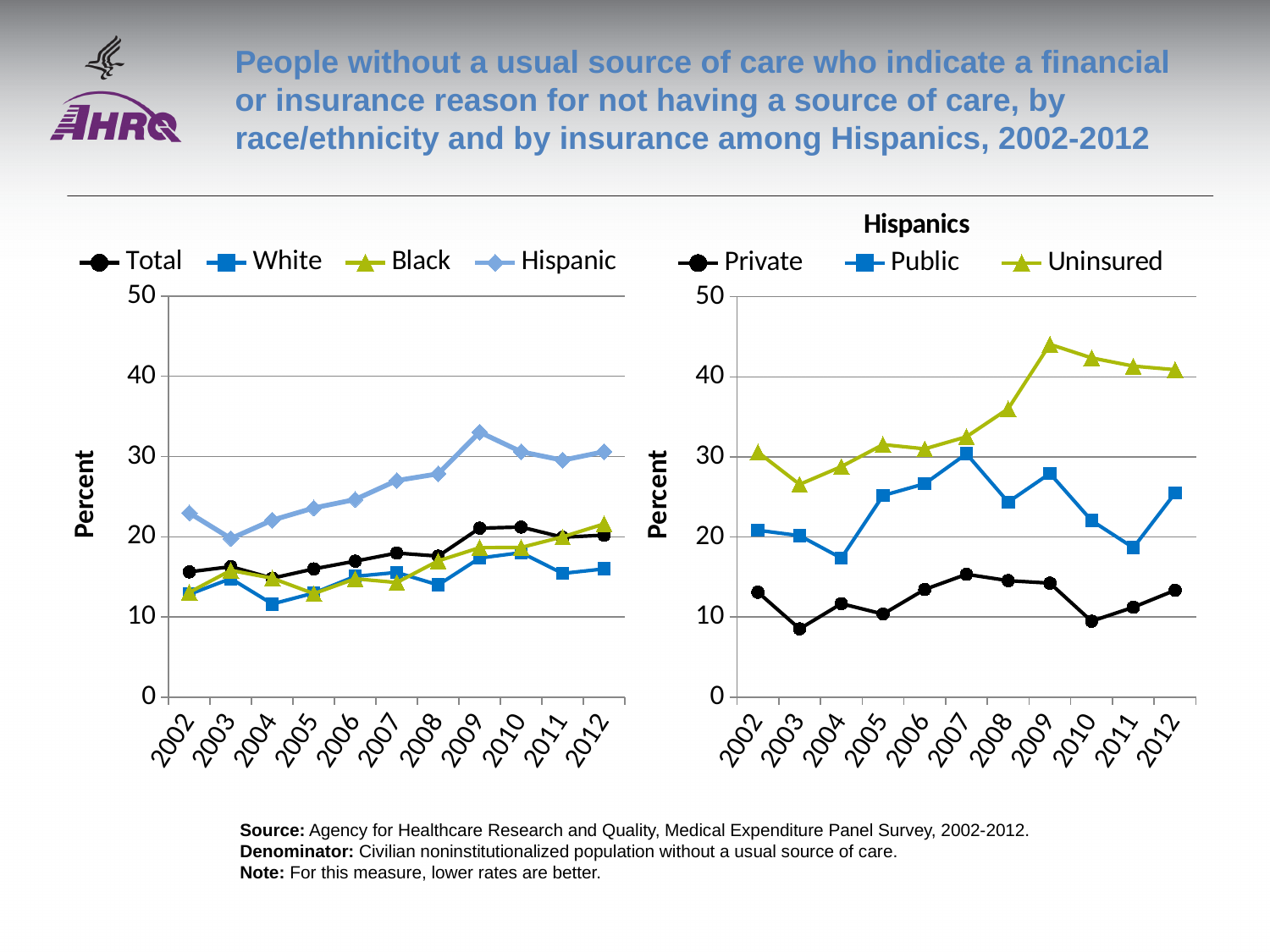
How many years are shown on the x axis of the right chart (Hispanics)? 11 How many series does the legend of the left chart list? 4 In the left chart, which series has the highest value in 2009? Hispanic In the left chart, is the value for Hispanic in 2009 greater or less than 30? greater In the right chart (Hispanics), which series has the lowest value in 2012? Private In the right chart (Hispanics), is the value for Private in 2003 greater or less than 10? less How many series does the legend of the right chart (Hispanics) list? 3 In the right chart (Hispanics), does the Uninsured line overall rise or fall from 2002 to 2012? rise In the right chart (Hispanics), which is larger in 2012, Uninsured or Public? Uninsured In the left chart, is the value for Hispanic in 2007 greater or less than 30? less What kind of chart is the left chart on the slide? line chart